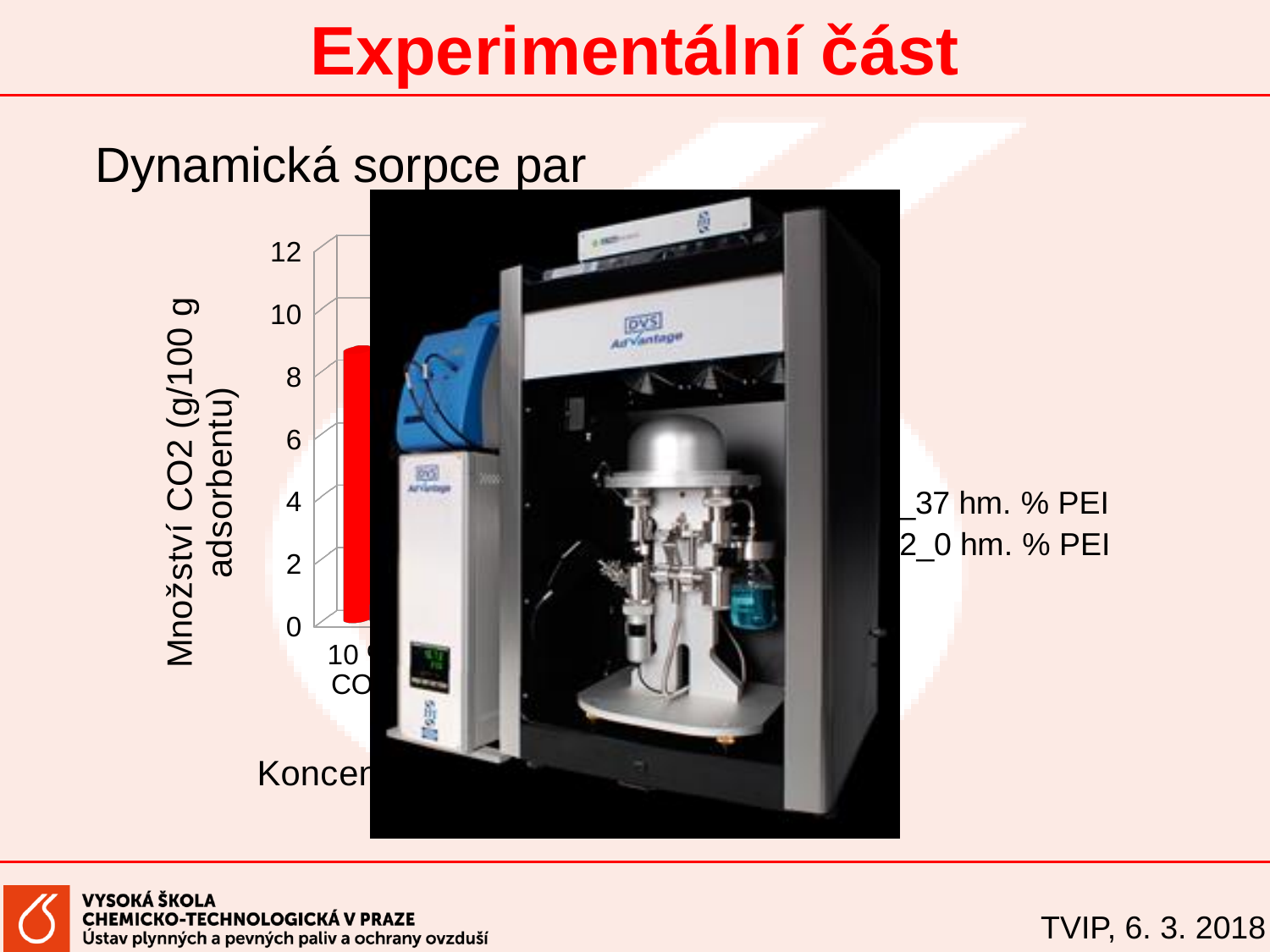
What is the label of the vertical axis of the chart? Množství CO2 (g/100 g adsorbentu) What is the highest tick value shown on the vertical axis of the chart? 12 Is the value of the red bar in the chart greater or less than 10? less Is the value of the red bar in the chart greater or less than 8? greater What kind of chart is partially visible on the slide? bar chart